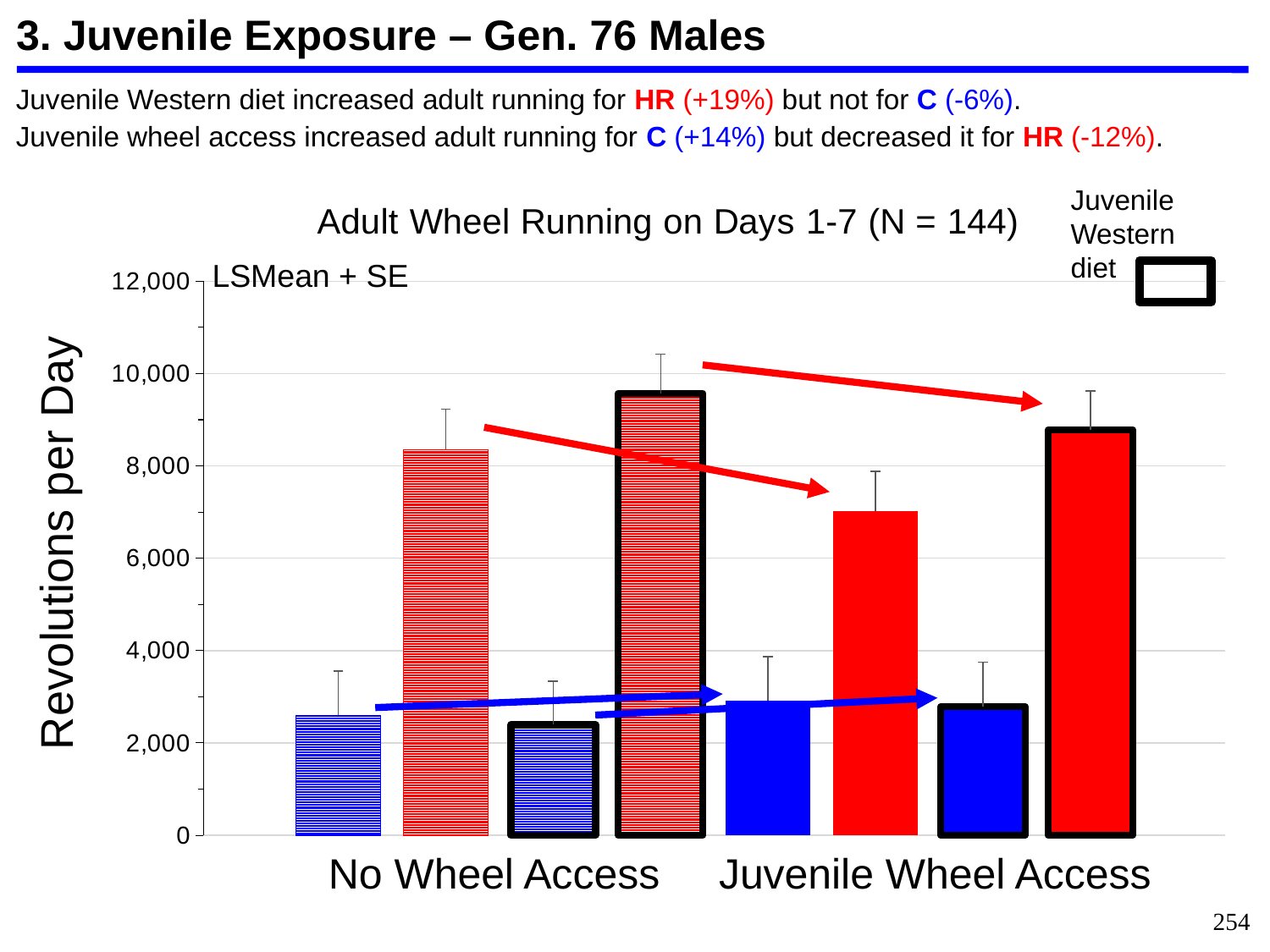
What is the label on the vertical axis of the chart? Revolutions per Day Is the value of the red bar with a thick black outline in the No Wheel Access group greater or less than 8,000? greater Which is larger: the red bar without a black outline in the No Wheel Access group or the red bar without a black outline in the Juvenile Wheel Access group? the red bar without a black outline in the No Wheel Access group Which bar in the chart is the tallest? the red bar with a thick black outline in the No Wheel Access group How many groups are labelled along the x axis of the chart? 2 Is the value of the blue bar without a black outline in the No Wheel Access group greater or less than 4,000? less How many bars are plotted in the chart in total? 8 Is the value of the red bar without a black outline in the Juvenile Wheel Access group greater or less than 8,000? less What is the title of the chart? Adult Wheel Running on Days 1-7 (N = 144) What is the highest value shown on the vertical axis of the chart? 12,000 What kind of chart is shown on the slide? bar chart